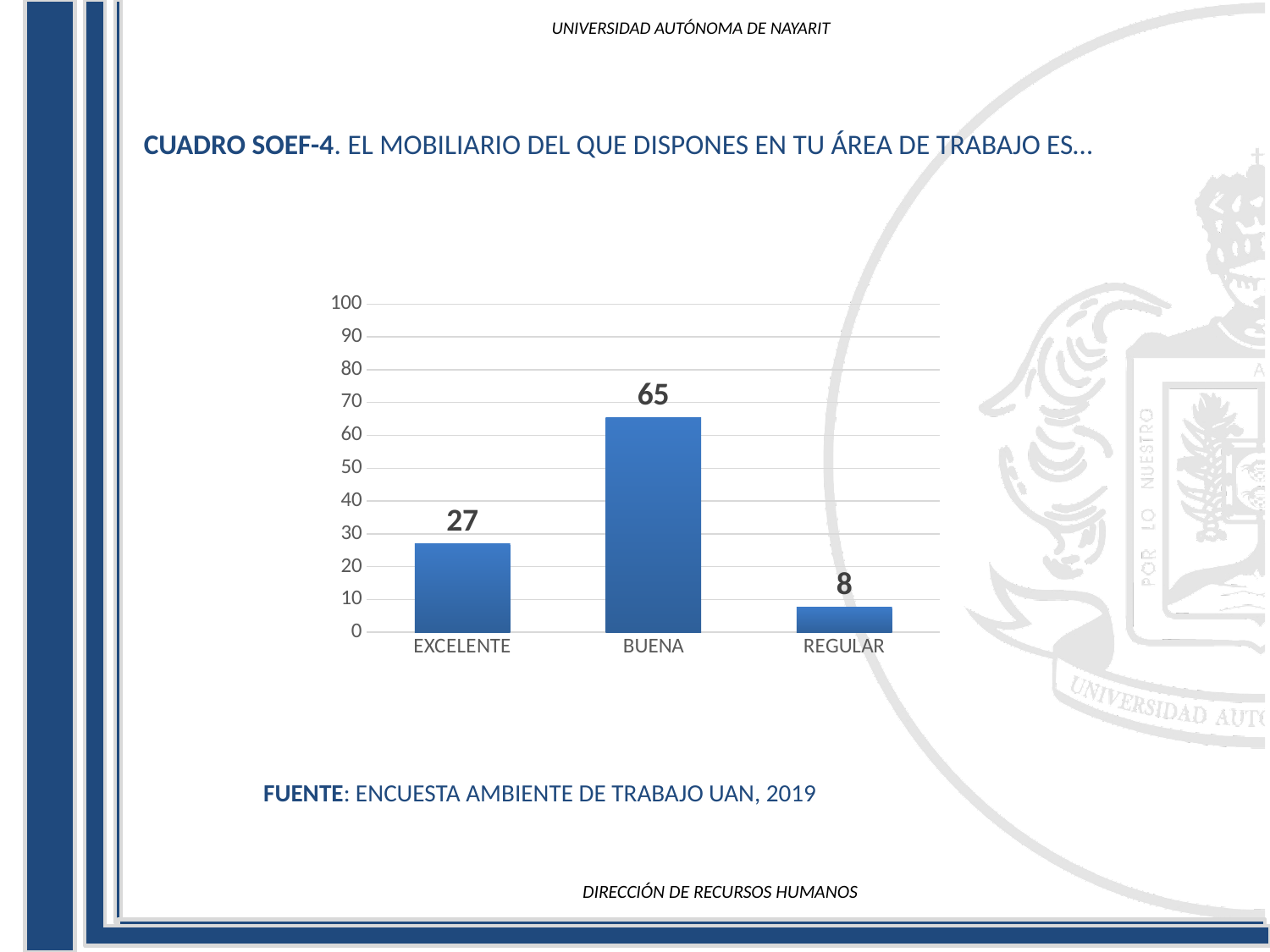
What is the value for BUENA? 65 How many categories are shown on the x axis? 3 What is the maximum value shown on the vertical axis? 100 What is the difference between the values for BUENA and EXCELENTE? 38 What is the value for EXCELENTE? 27 What kind of chart is shown on the slide? bar chart Which category has the lowest value? REGULAR What is the difference between the values for EXCELENTE and REGULAR? 19 Is the value for BUENA greater or less than 50? greater What is the value for REGULAR? 8 Which is larger, the value for EXCELENTE or the value for REGULAR? EXCELENTE Which category has the highest value? BUENA